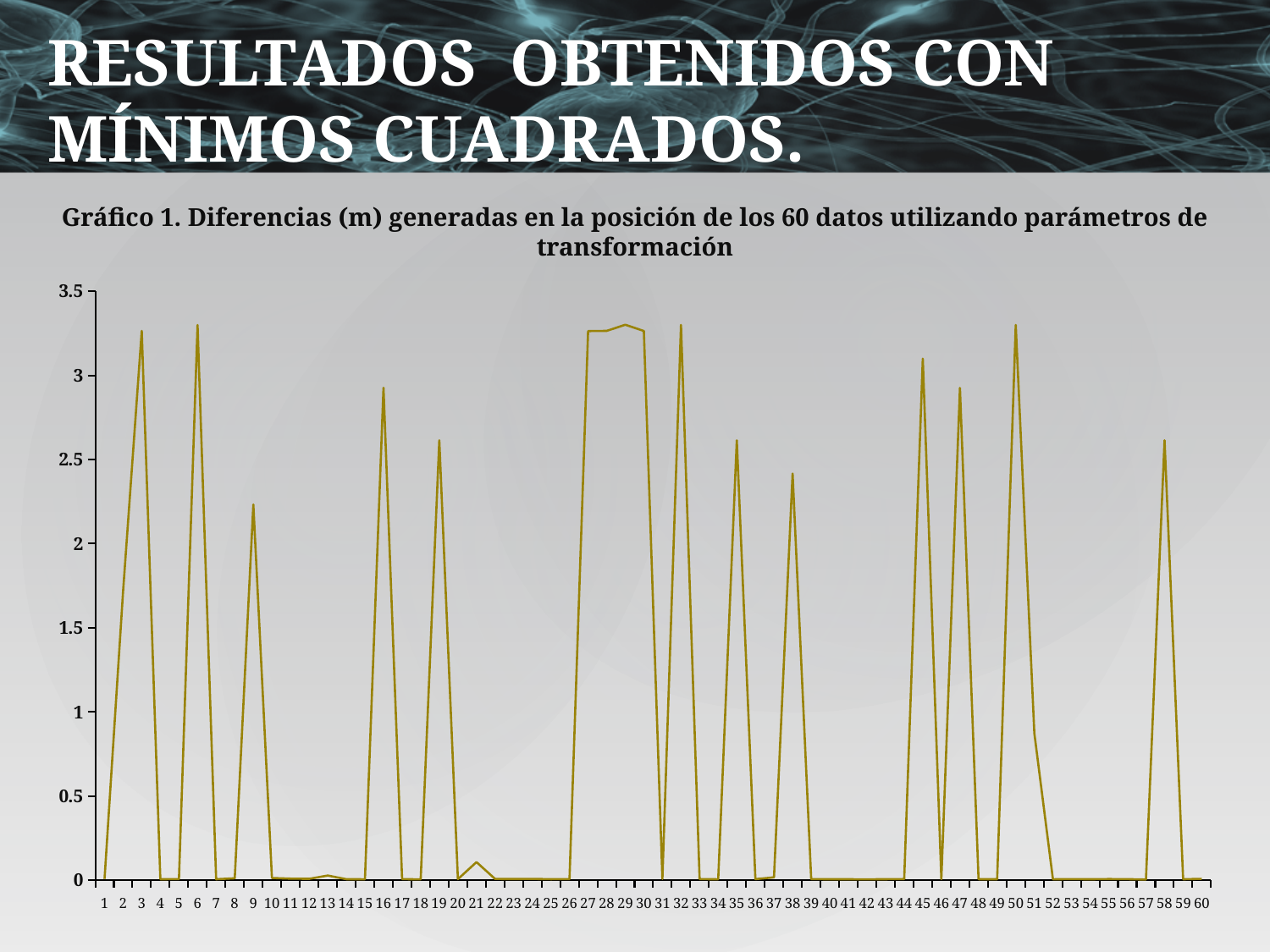
Is the value at point 9 greater or less than 2? greater Is the value at point 45 greater or less than 3? greater Is the value at point 21 greater or less than 0.5? less What kind of chart is shown on the slide? line chart Which has the larger value, point 9 or point 16? point 16 How many data points are plotted along the x axis? 60 Which has the larger value, point 38 or point 45? point 45 What is the title of the chart? Gráfico 1. Diferencias (m) generadas en la posición de los 60 datos utilizando parámetros de transformación